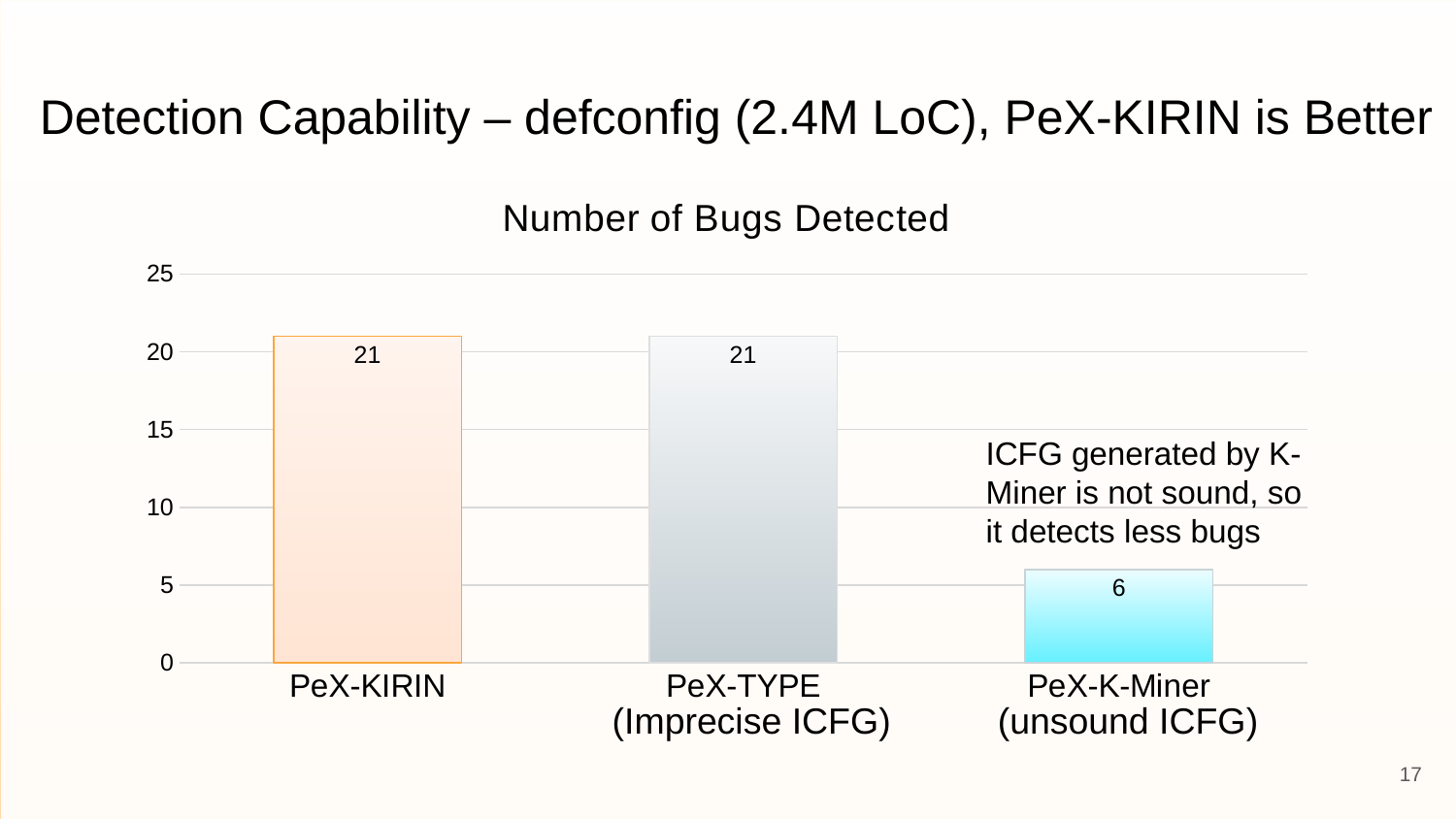
What is the title of the chart? Number of Bugs Detected What is the number of bugs detected by PeX-K-Miner (unsound ICFG)? 6 Is the value for PeX-KIRIN greater or less than 20? greater How many categories are shown in the chart? 3 What kind of chart is shown on the slide? Bar chart What is the number of bugs detected by PeX-TYPE (Imprecise ICFG)? 21 What is the number of bugs detected by PeX-KIRIN? 21 Which category has the lowest number of bugs detected? PeX-K-Miner (unsound ICFG) What is the difference in bugs detected between PeX-KIRIN and PeX-K-Miner? 15 Which detects more bugs, PeX-TYPE or PeX-K-Miner? PeX-TYPE What is the maximum value shown on the y axis? 25 Is the value for PeX-K-Miner greater or less than 10? less